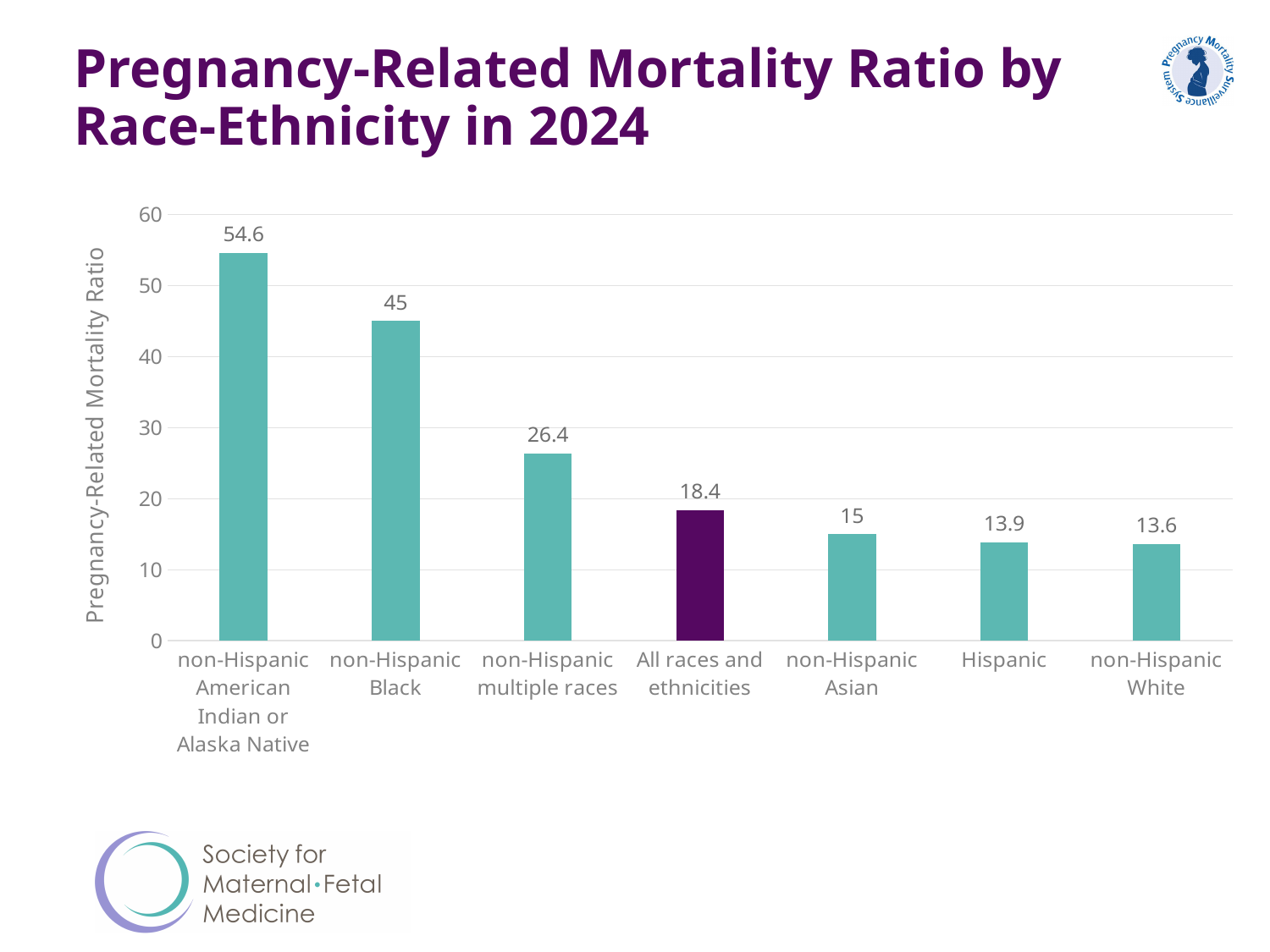
What is the pregnancy-related mortality ratio for Hispanic? 13.9 What is the pregnancy-related mortality ratio for non-Hispanic Black? 45 What kind of chart is shown on the slide? bar chart What is the difference between the values for non-Hispanic Black and non-Hispanic multiple races? 18.6 Which bar is coloured differently (dark purple) from the others? All races and ethnicities Which category has the lowest pregnancy-related mortality ratio? non-Hispanic White Which category has the highest pregnancy-related mortality ratio? non-Hispanic American Indian or Alaska Native How many categories are shown on the x axis? 7 Is the value for non-Hispanic multiple races greater or less than 30? less What is the pregnancy-related mortality ratio for non-Hispanic American Indian or Alaska Native? 54.6 Which is larger, the value for non-Hispanic Asian or the value for non-Hispanic White? non-Hispanic Asian What is the value shown for All races and ethnicities? 18.4